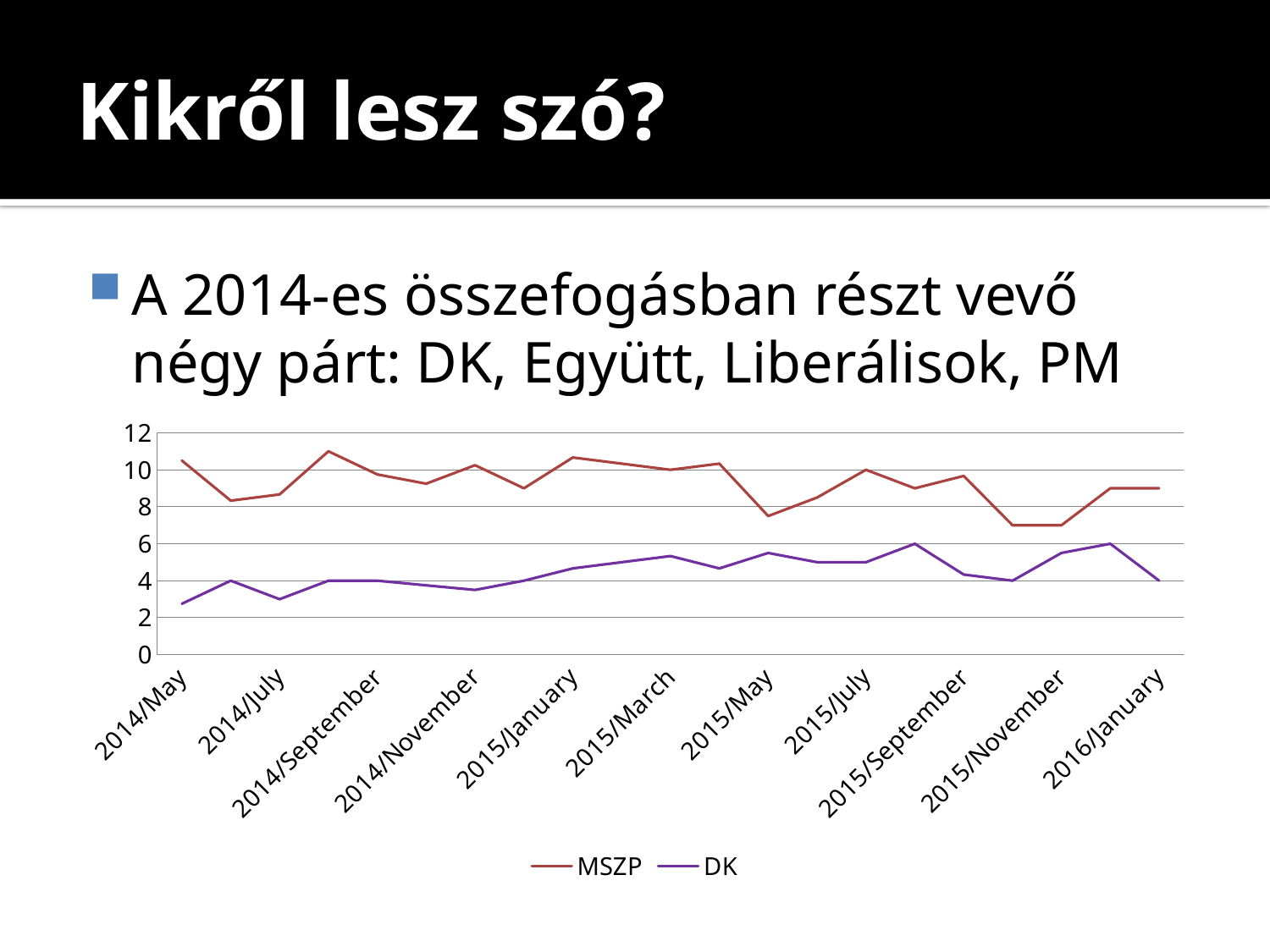
Which two series are listed in the chart's legend? MSZP and DK Which series is drawn in purple? DK At 2015/March, which series has the higher value, MSZP or DK? MSZP Does the MSZP line rise or fall between 2015/September and 2015/November? fall Is the value for MSZP at 2015/November greater or less than 8? less Is the value for DK at 2014/May greater or less than 4? less How many series does the chart's legend list? 2 Is the value for DK at 2015/March greater or less than 4? greater What kind of chart is shown on the slide? line chart Which series stays above the other across the whole period shown? MSZP Does the DK line rise or fall between 2014/November and 2015/March? rise